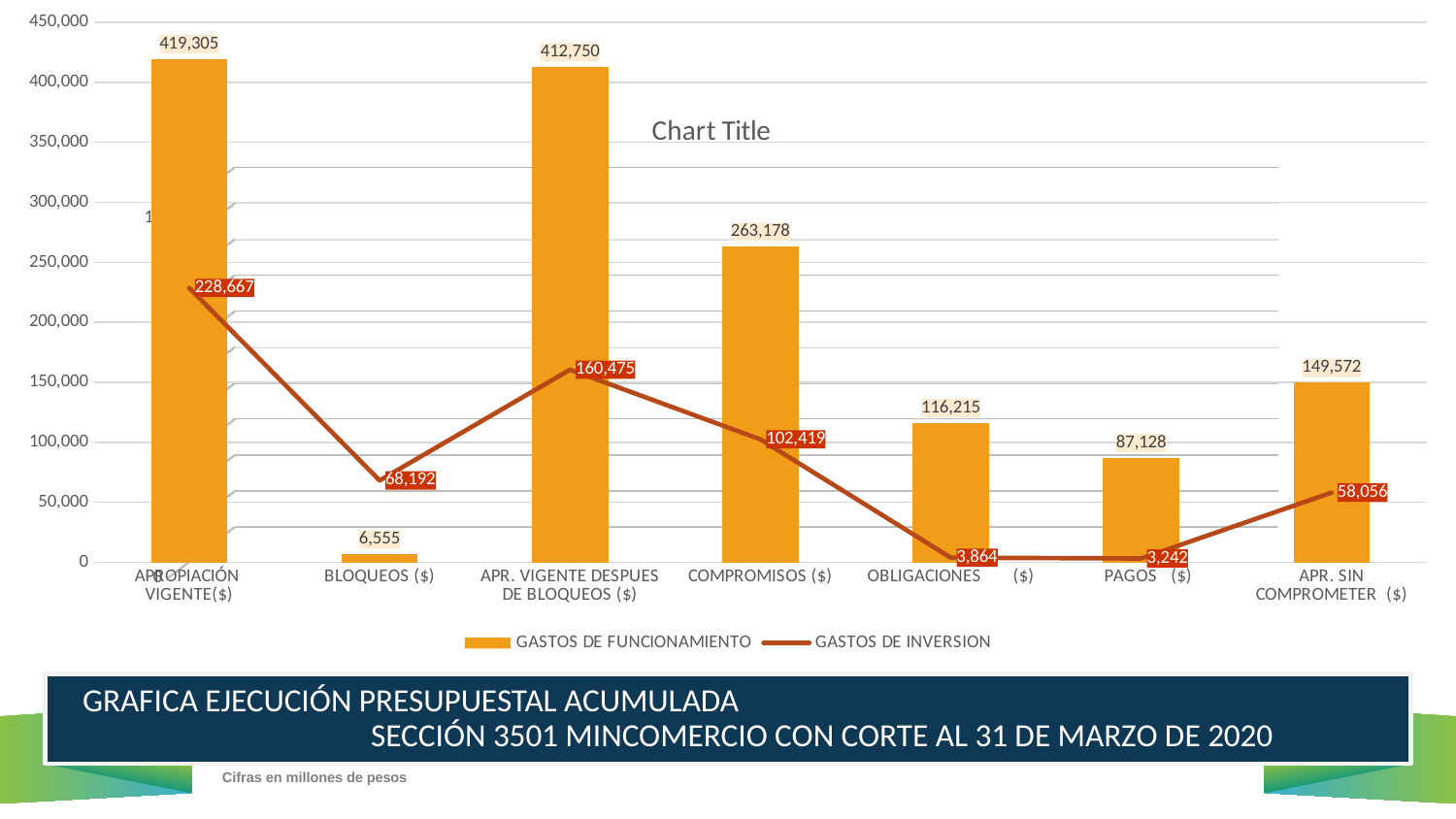
How many series does the legend list? 2 Which category has the highest GASTOS DE INVERSION value? APROPIACIÓN VIGENTE($) What is the GASTOS DE INVERSION value for APR. SIN COMPROMETER ($)? 58,056 What is the GASTOS DE INVERSION value for COMPROMISOS ($)? 102,419 Which series is drawn as a line rather than bars? GASTOS DE INVERSION What is the GASTOS DE FUNCIONAMIENTO value for APROPIACIÓN VIGENTE($)? 419,305 Which is larger for OBLIGACIONES ($): GASTOS DE FUNCIONAMIENTO or GASTOS DE INVERSION? GASTOS DE FUNCIONAMIENTO Which category has the lowest GASTOS DE FUNCIONAMIENTO value? BLOQUEOS ($) Is the GASTOS DE FUNCIONAMIENTO value for COMPROMISOS ($) greater or less than 250,000? greater How many categories are shown on the x axis? 7 What is the difference between the GASTOS DE FUNCIONAMIENTO values for APROPIACIÓN VIGENTE($) and APR. VIGENTE DESPUES DE BLOQUEOS ($)? 6,555 What is the GASTOS DE FUNCIONAMIENTO value for PAGOS ($)? 87,128